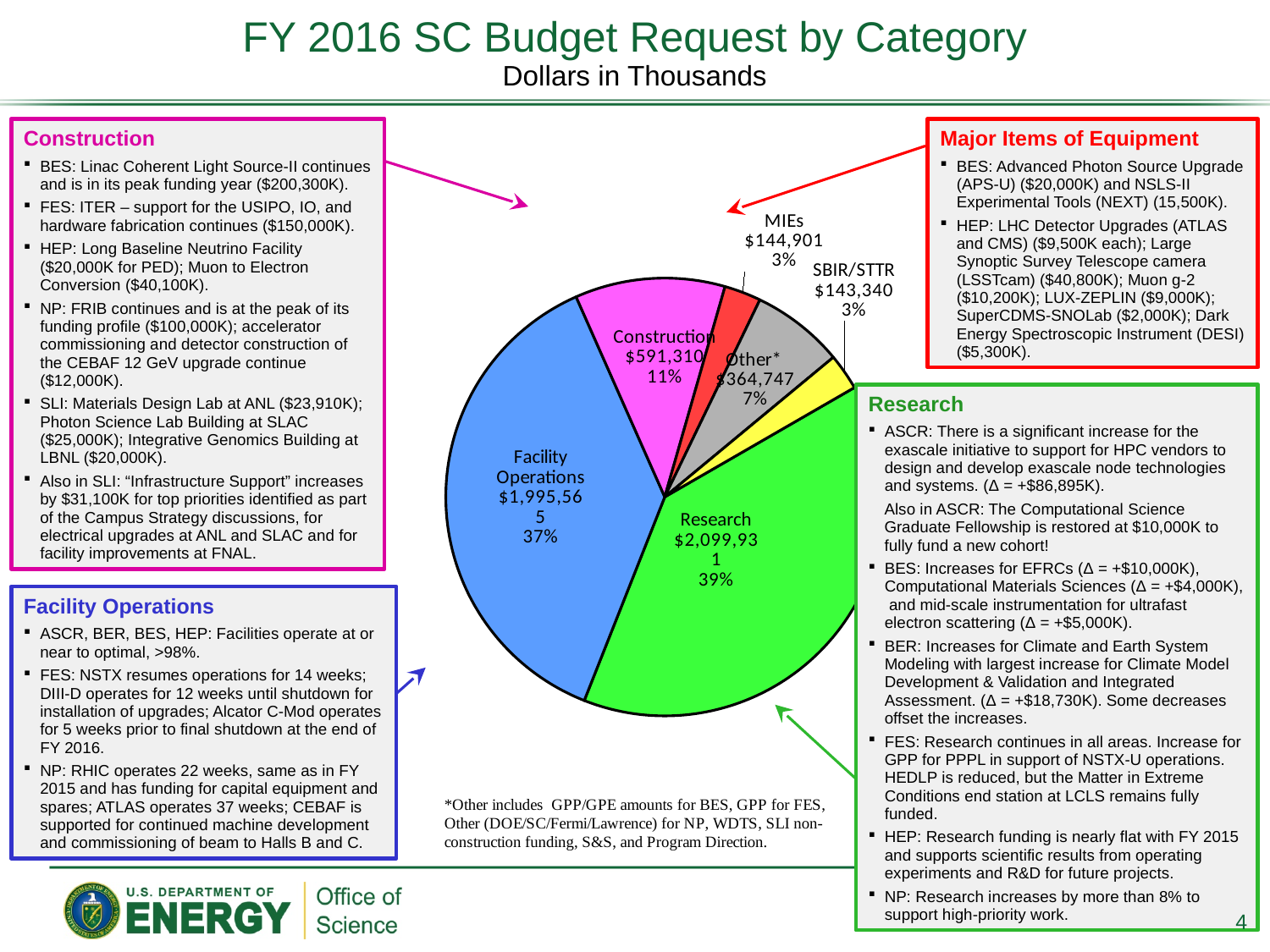
What is the value shown for SBIR/STTR in the pie chart? $143,340 What is the value shown for Construction in the pie chart? $591,310 What percentage share of the pie does Facility Operations represent? 37% What is the value shown for Facility Operations in the pie chart? $1,995,565 Which is larger, the value for MIEs or the value for SBIR/STTR? MIEs What percentage share of the pie does Other* represent? 7% How many slices does the pie chart have? 6 What is the title of the slide containing the pie chart? FY 2016 SC Budget Request by Category Which category has the largest slice in the pie chart? Research What kind of chart is shown on the slide? pie chart What is the value shown for Research in the pie chart? $2,099,931 What is the difference between the Research value and the Facility Operations value? $104,366